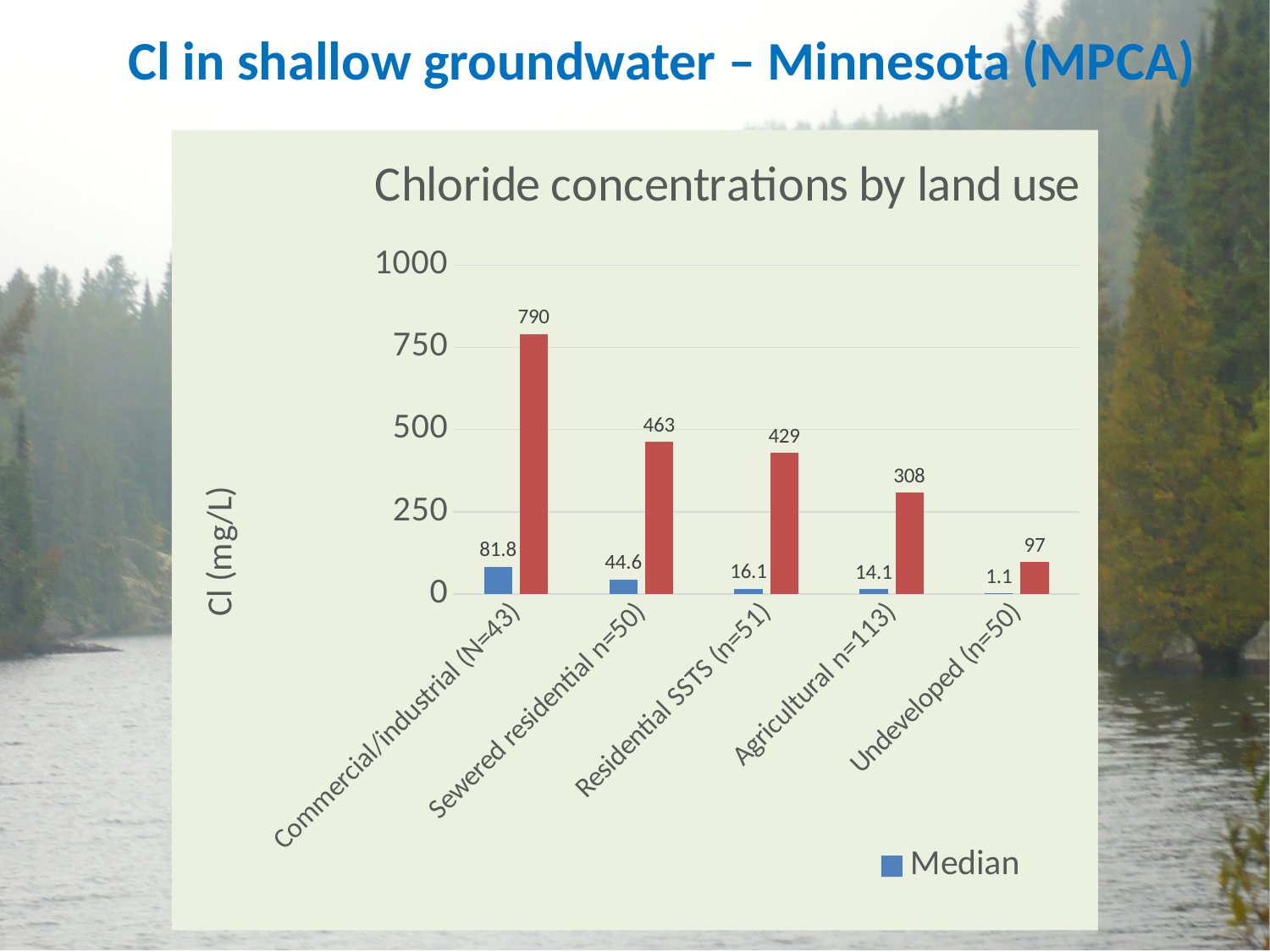
Which land use category has the lowest red bar value? Undeveloped (n=50) What is the difference between the red bar values for Commercial/industrial (N=43) and Sewered residential n=50? 327 Which has a larger median value, Residential SSTS (n=51) or Agricultural n=113? Residential SSTS (n=51) Which land use category has the highest median chloride concentration? Commercial/industrial (N=43) What type of chart is shown on the slide? bar chart How many land use categories are shown on the x axis? 5 What value is labelled on the red bar for Sewered residential n=50? 463 What value is labelled on the red bar for Agricultural n=113? 308 What is the label on the vertical axis of the chart? Cl (mg/L) What is the median chloride concentration for Commercial/industrial (N=43)? 81.8 What is the median value shown for Undeveloped (n=50)? 1.1 Is the red bar value for Residential SSTS (n=51) greater or less than 500? less